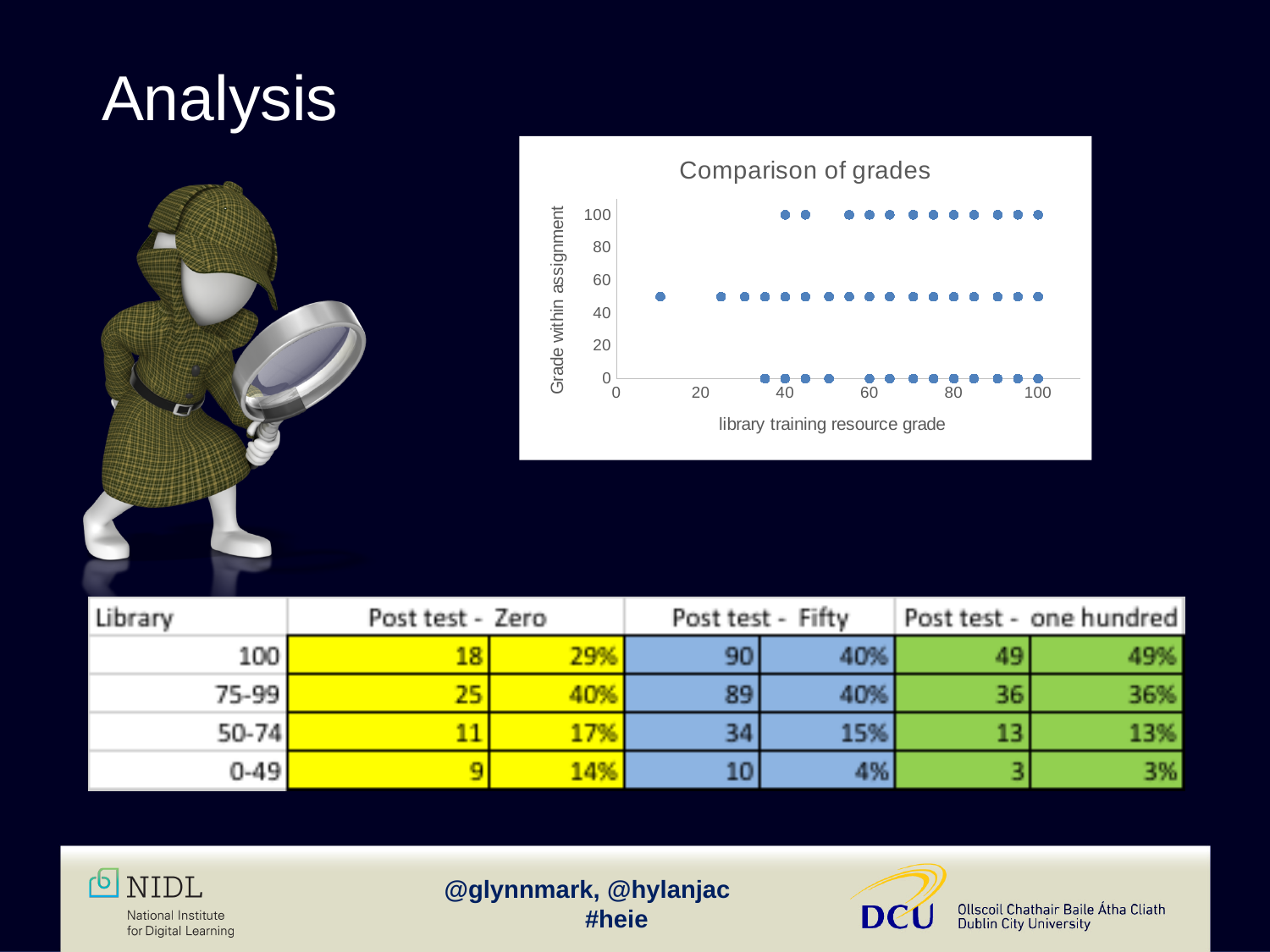
Is the smallest library training resource grade plotted in the chart greater or less than 20? less What is the highest 'Grade within assignment' value reached by any point in the chart? 100 Is the smallest library training resource grade among the points at a grade within assignment of 0 greater or less than 20? greater Is the smallest library training resource grade among the points at a grade within assignment of 100 greater or less than 20? greater What is the lowest 'Grade within assignment' value reached by any point in the chart? 0 What is the title of the chart? Comparison of grades What is the label of the vertical axis of the chart? Grade within assignment What kind of chart is shown on the slide? scatter chart How many distinct horizontal rows of points does the chart show? 3